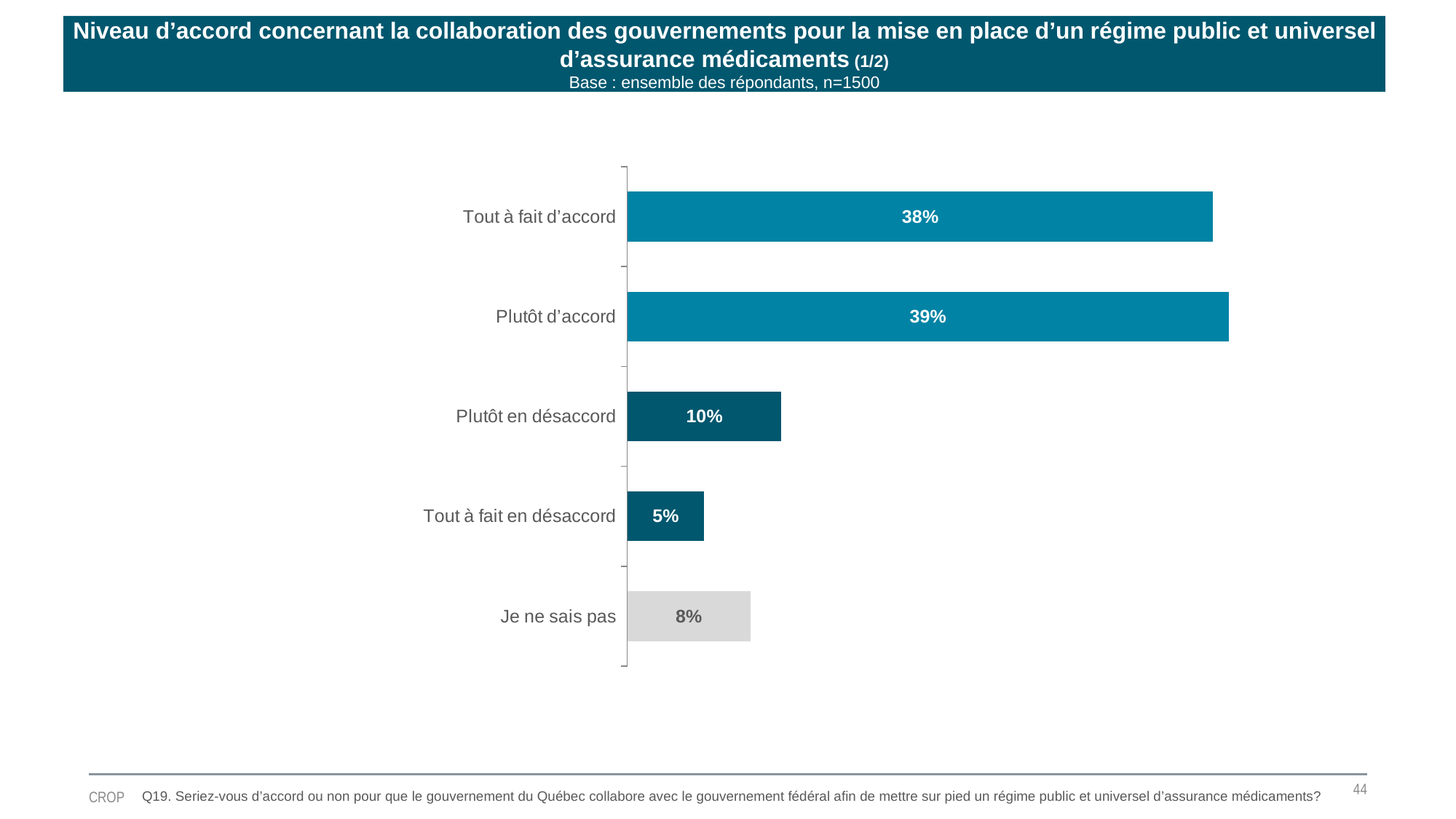
What is the base (number of respondents) stated under the chart title? n=1500 How many categories are shown in the chart? 5 What is the value for "Je ne sais pas"? 8% Which category has the highest value? Plutôt d'accord What is the difference between "Plutôt en désaccord" and "Tout à fait en désaccord"? 5% What percentage of respondents answered "Tout à fait d'accord"? 38% What percentage is shown for "Plutôt en désaccord"? 10% What is the value shown for "Plutôt d'accord"? 39% Which is larger: the value for "Je ne sais pas" or the value for "Tout à fait en désaccord"? Je ne sais pas What type of chart is shown on the slide? Bar chart What is the difference between "Plutôt d'accord" and "Tout à fait d'accord"? 1% Which category has the lowest value? Tout à fait en désaccord